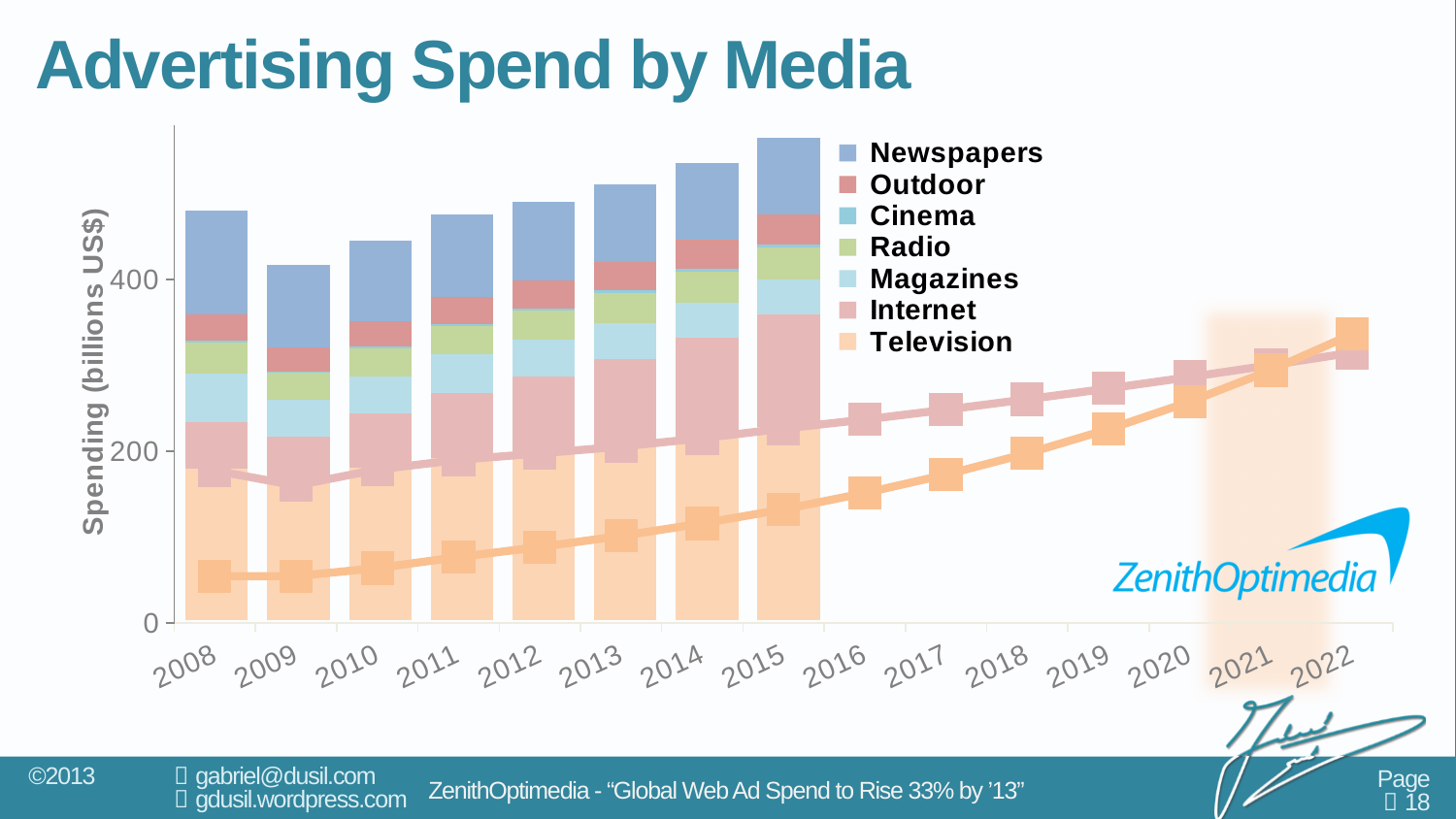
How many years are shown along the x axis? 15 What is the label on the vertical axis? Spending (billions US$) Is the Internet value for 2022 greater or less than 200? greater Which year has the shortest stacked bar? 2009 Is the Television value for 2008 greater or less than 200? less In 2008, which is larger, the Internet value or the Television value? Television Does the Television line rise or fall from 2008 to 2022? rise What is the title of the chart? Advertising Spend by Media Which year has the tallest stacked bar? 2015 What kind of chart is shown on the slide? a combination chart with stacked bars and lines How many series does the legend list? 7 Is the total of the stacked bar for 2015 greater or less than 400? greater